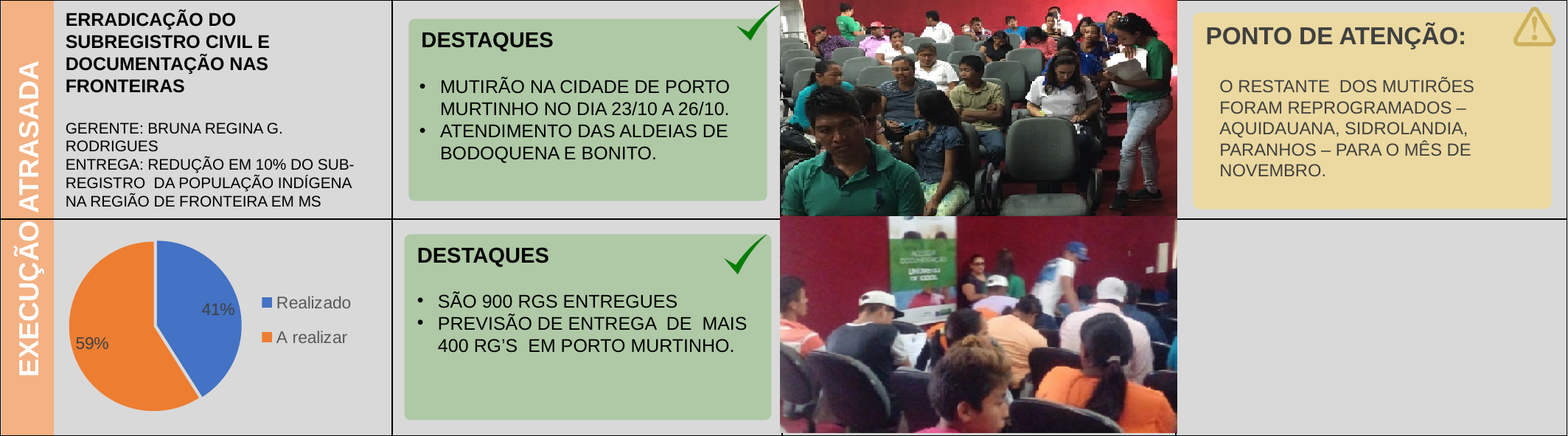
What is the value for Realizado in the pie chart? 41% What colour is the Realizado slice in the pie chart? blue Which slice of the pie chart is the smallest? Realizado What colour is the A realizar slice in the pie chart? orange What is the value for A realizar in the pie chart? 59% What share of the pie does the Realizado slice represent? 41% How many entries does the legend of the pie chart list? 2 How many slices does the pie chart have? 2 What is the difference between the A realizar and Realizado slices? 18% Which is larger, Realizado or A realizar? A realizar What kind of chart is shown on the slide? pie chart Which slice of the pie chart is the largest? A realizar